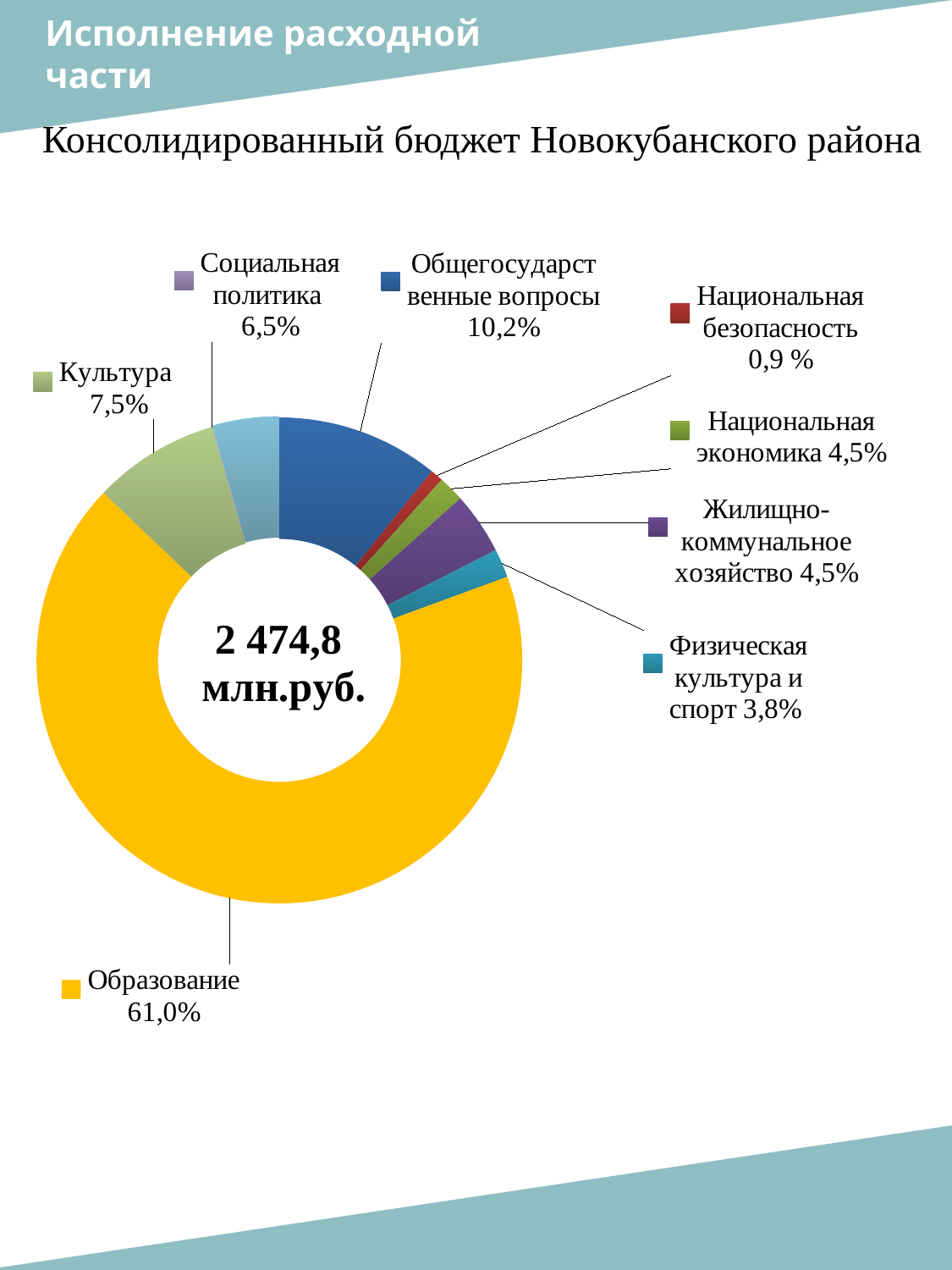
What total amount is printed in the centre of the chart? 2 474,8 млн.руб. What share is shown for Общегосударственные вопросы? 10,2% What kind of chart is shown on the slide? Pie (donut) chart What colour is the Образование segment of the chart? Yellow Which category has the smallest share of the chart? Национальная безопасность How many categories are shown in the chart? 8 By how many percentage points does the share of Образование exceed that of Общегосударственные вопросы? 50,8 What share is shown for Физическая культура и спорт? 3,8% Which has the larger share, Культура or Социальная политика? Культура What share is shown for Национальная безопасность? 0,9 % Which category has the largest share of the chart? Образование What share of the chart does Образование account for? 61,0%